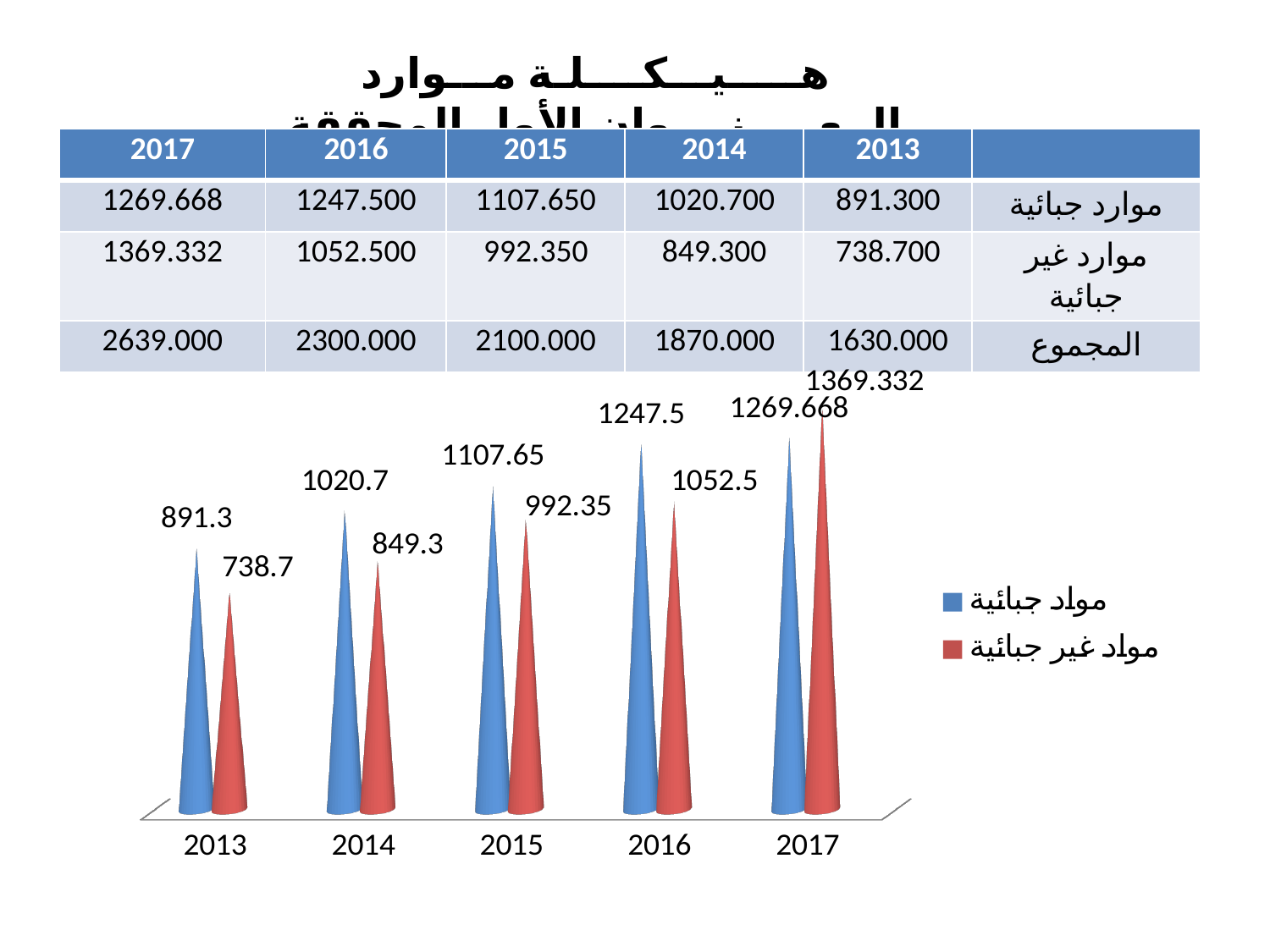
What is the value for موارد جبائية in 2015 on the chart? 1107.65 What is the difference between موارد جبائية and موارد غير جبائية in 2016 on the chart? 195 In 2017, which is larger on the chart: موارد جبائية or موارد غير جبائية? موارد غير جبائية How many series does the chart legend list? 2 In which year is موارد جبائية highest on the chart? 2017 What is the value for موارد غير جبائية in 2017 on the chart? 1369.332 Do the values for موارد غير جبائية rise or fall from 2013 to 2017 on the chart? rise What is the value for موارد غير جبائية in 2014 on the chart? 849.3 What kind of chart is shown on the slide? bar chart By how much did موارد جبائية increase from 2013 to 2017 on the chart? 378.368 In which year is موارد غير جبائية lowest on the chart? 2013 How many years are shown on the chart's x axis? 5